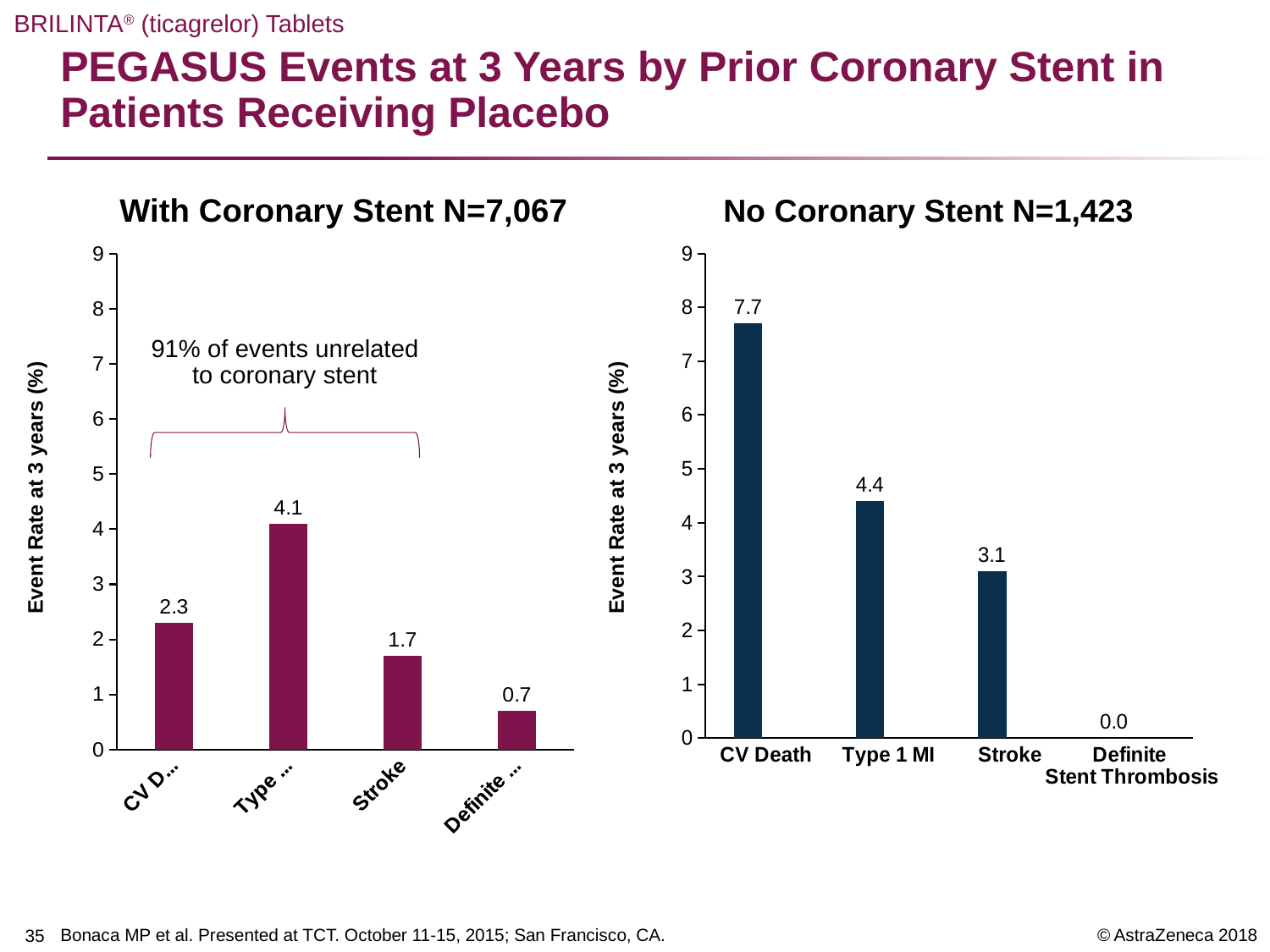
In the No Coronary Stent N=1,423 chart, what is the event rate for Type 1 MI? 4.4 In the With Coronary Stent N=7,067 chart, what is the highest event rate value shown? 4.1 In the No Coronary Stent N=1,423 chart, how many categories are shown on the x axis? 4 What kind of chart is the With Coronary Stent N=7,067 chart? Bar chart In the With Coronary Stent N=7,067 chart, what percentage of events does the annotation say are unrelated to coronary stent? 91% In the No Coronary Stent N=1,423 chart, which category has the highest event rate? CV Death In the With Coronary Stent N=7,067 chart, what is the event rate for Stroke? 1.7 In the No Coronary Stent N=1,423 chart, what is the event rate for Definite Stent Thrombosis? 0.0 In the No Coronary Stent N=1,423 chart, which category has the lowest event rate? Definite Stent Thrombosis In the No Coronary Stent N=1,423 chart, what is the difference between the event rates for CV Death and Stroke? 4.6 In the No Coronary Stent N=1,423 chart, which is larger, the event rate for Type 1 MI or for Stroke? Type 1 MI In the No Coronary Stent N=1,423 chart, what is the event rate for CV Death? 7.7